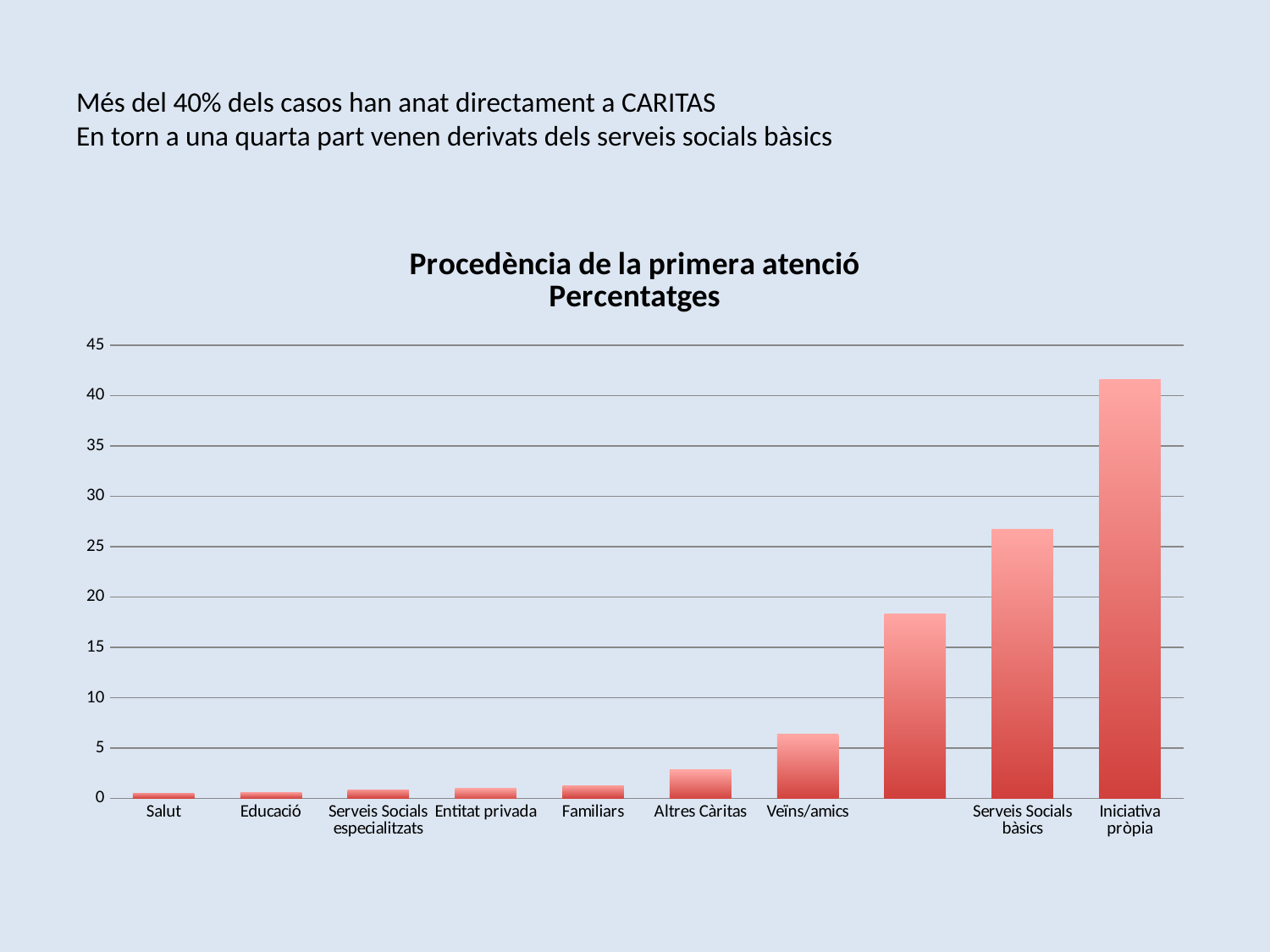
What is the title of the chart? Procedència de la primera atenció Percentatges Which is larger, the value for Serveis Socials bàsics or the value for Veïns/amics? Serveis Socials bàsics Which is larger, the value for Familiars or the value for Altres Càritas? Altres Càritas Is the value for Iniciativa pròpia greater or less than 40? greater What is the highest value shown on the vertical axis? 45 Is the value for Serveis Socials bàsics greater or less than 25? greater What kind of chart is shown on the slide? bar chart Is the value for Serveis Socials bàsics greater or less than 30? less Which category has the highest value in the chart? Iniciativa pròpia Do the bar values generally rise or fall from left to right along the x axis? rise